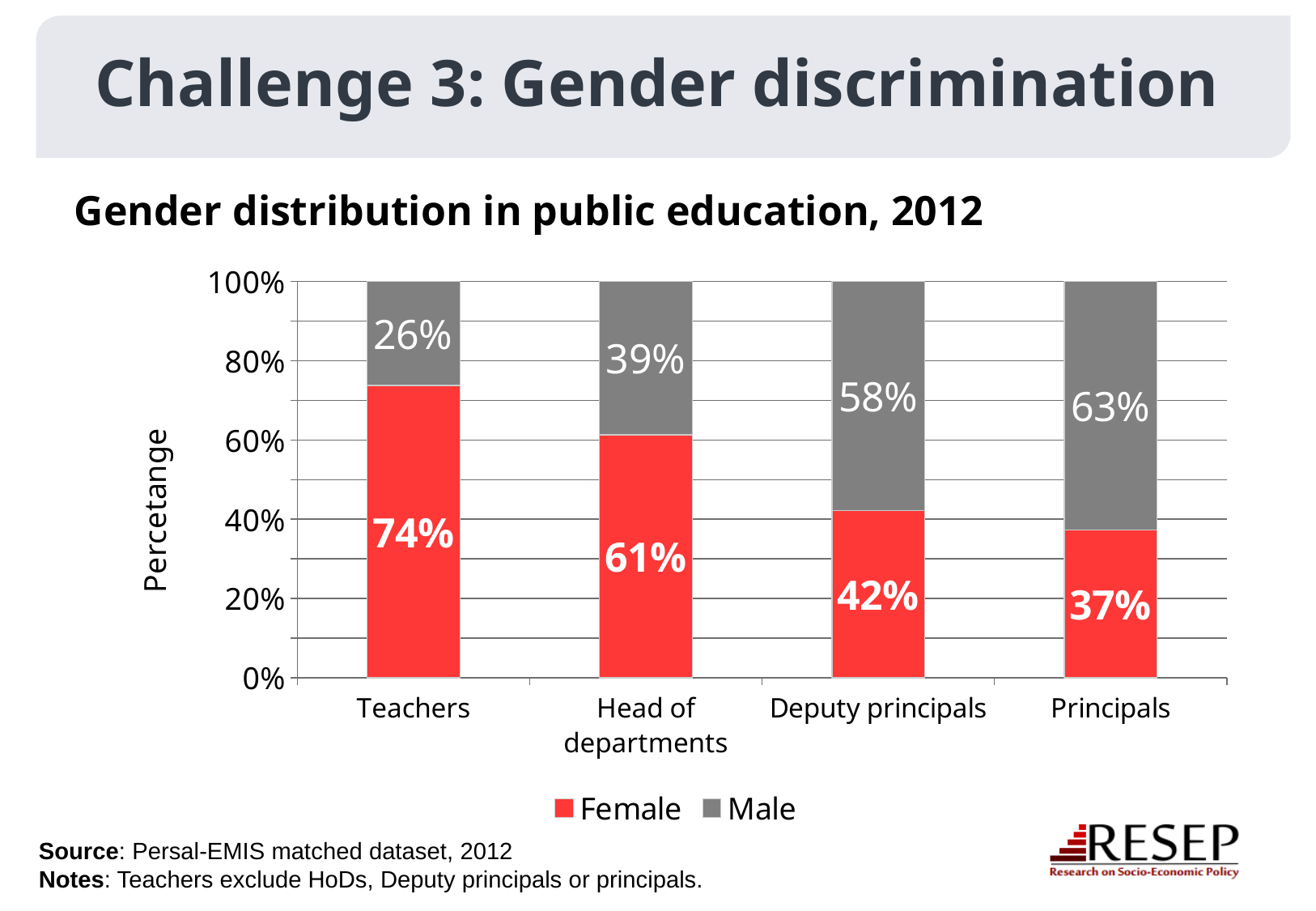
How many categories are shown on the x axis? 4 What is the difference between the Female percentage for Teachers and the Female percentage for Principals? 37% What is the Female percentage for Teachers? 74% What is the Male percentage for Head of departments? 39% Which category has the highest Female percentage? Teachers Which category has the lowest Female percentage? Principals Which is larger: the Male percentage for Deputy principals or the Male percentage for Head of departments? Deputy principals What kind of chart is shown on the slide? Stacked bar chart What is the Male percentage for Principals? 63% What is the Female percentage for Deputy principals? 42% How many series does the legend list? 2 Does the Female percentage rise or fall from Teachers to Principals along the x axis? Fall